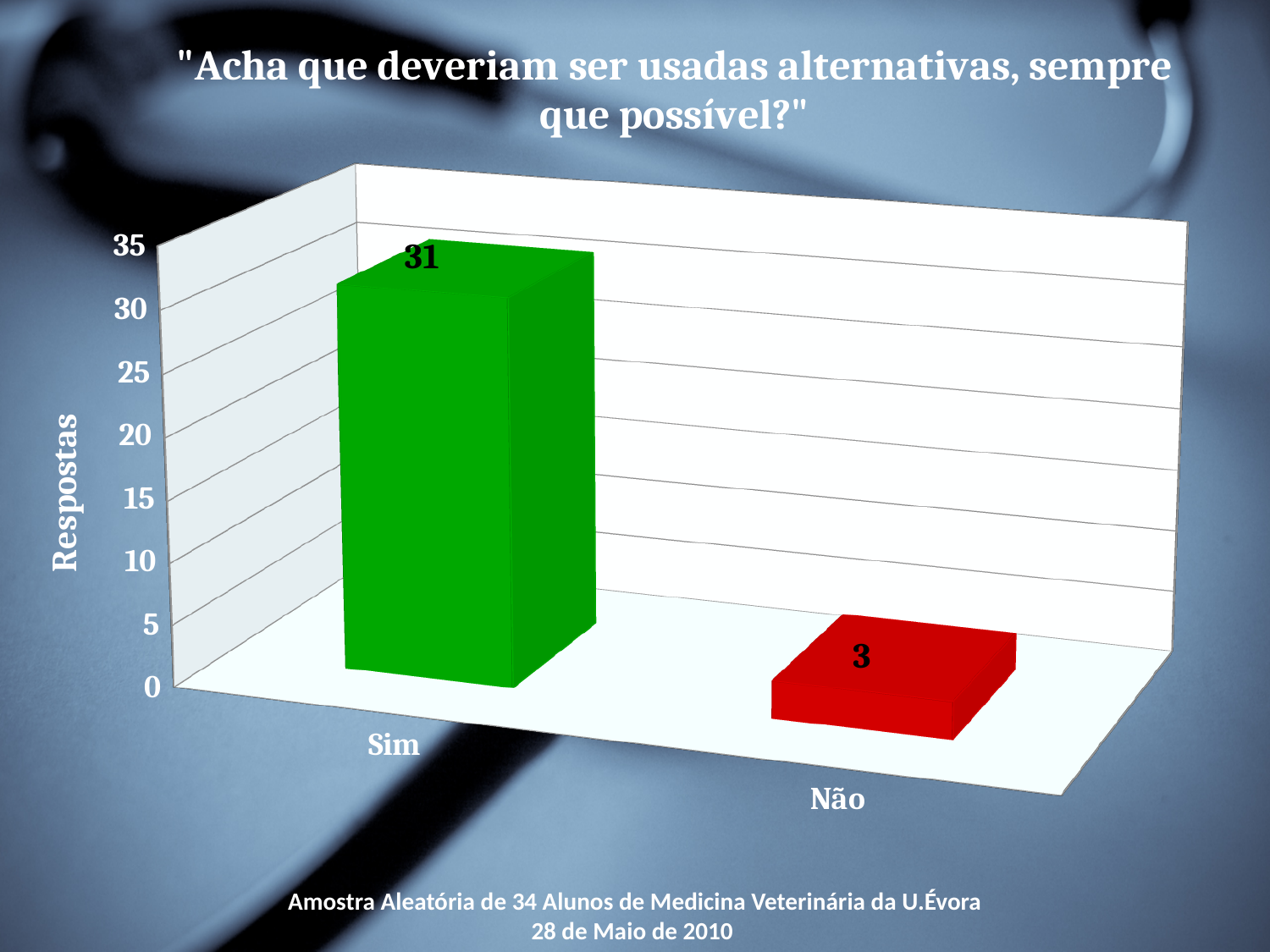
What kind of chart is shown on the slide? bar chart Which category has the highest value? Sim Is the value for Não greater or less than 5? less What colour is the bar for Não? red Which category has the lowest value? Não Is the value for Sim greater or less than 25? greater How many categories are shown on the x axis? 2 What is the label of the vertical axis? Respostas What is the value for Não? 3 What is the value for Sim? 31 What is the difference between the values for Sim and Não? 28 Which is larger, the value for Sim or the value for Não? Sim